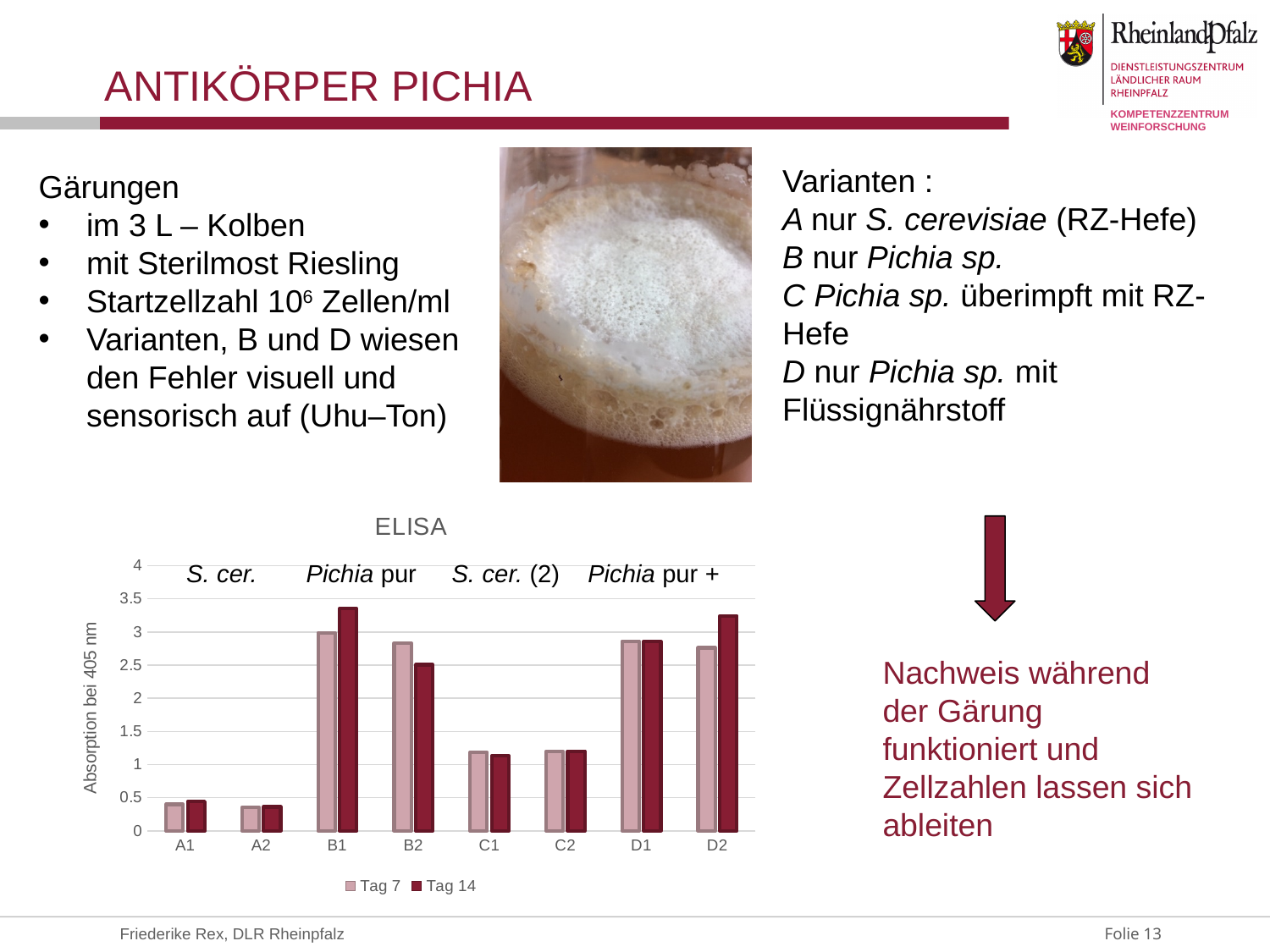
What are the two series named in the legend of the ELISA chart? Tag 7 and Tag 14 What is the y-axis label of the ELISA chart? Absorption bei 405 nm How many series does the legend of the ELISA chart list? 2 Is the Tag 7 value for C1 greater or less than 1.5? less Which is larger, the Tag 7 value for C1 or the Tag 7 value for D1? D1 Is the Tag 14 value for D2 greater or less than 3? greater Is the Tag 14 value for B2 greater or less than 2? greater What kind of chart is the ELISA chart? bar chart How many categories are shown on the x axis of the ELISA chart? 8 Which is larger, the Tag 14 value for B1 or the Tag 14 value for B2? B1